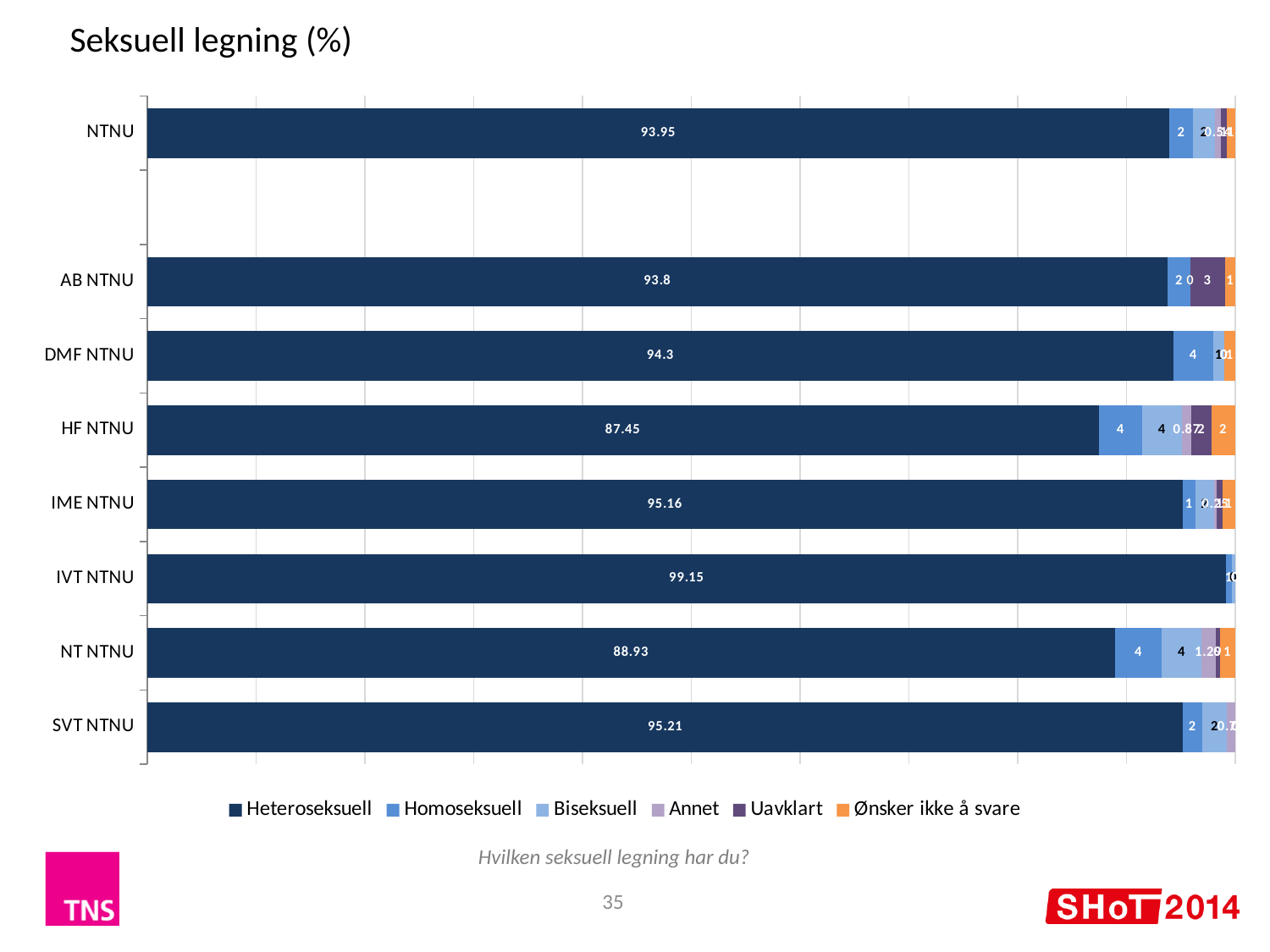
What kind of chart is shown on the slide? Stacked bar chart How many categories are shown on the y axis of the chart? 8 What is the difference between the Heteroseksuell values for IVT NTNU and HF NTNU? 11.7 Which has a larger Heteroseksuell value, DMF NTNU or AB NTNU? DMF NTNU What is the Heteroseksuell value for SVT NTNU? 95.21 What is the Homoseksuell value for HF NTNU? 4 What is the Heteroseksuell value for HF NTNU? 87.45 How many series does the legend list? 6 What is the Heteroseksuell value for NT NTNU? 88.93 Which category has the lowest Heteroseksuell value? HF NTNU What is the Heteroseksuell value for NTNU? 93.95 Which category has the highest Heteroseksuell value? IVT NTNU